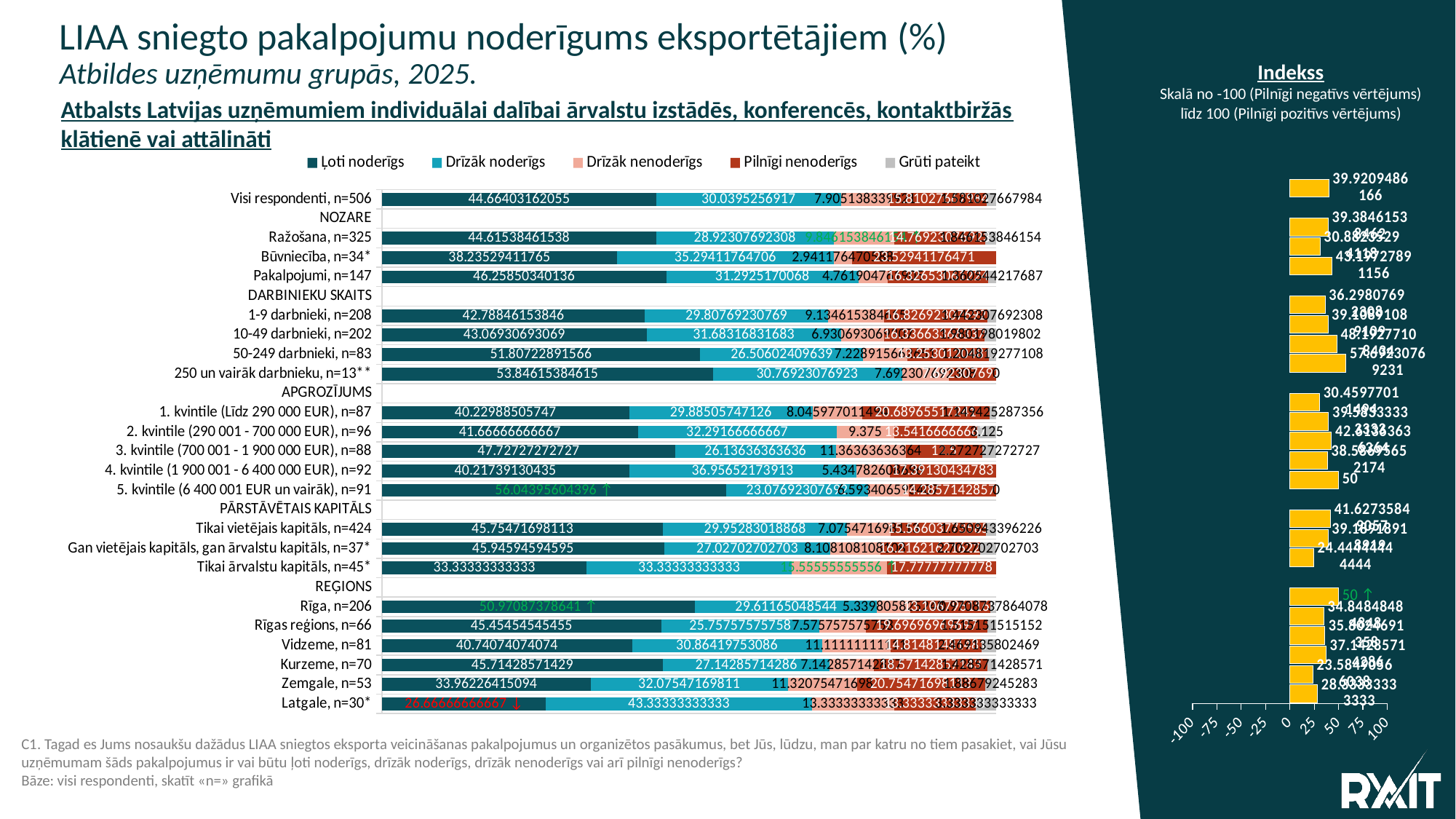
In the Indekss chart, is the value for 'Visi respondenti, n=506' greater or less than 25? greater What kind of chart is used to show the usefulness ratings by respondent group? Stacked bar chart In the Indekss chart, what is the index value for 'Visi respondenti, n=506'? 39.9209486166 In the main chart, what is the 'Drīzāk noderīgs' value for 'Latgale, n=30*'? 43.33333333333 In the main chart, what is the 'Ļoti noderīgs' value for '250 un vairāk darbinieku, n=13**'? 53.84615384615 In the main chart, which respondent group has the lowest 'Ļoti noderīgs' value? Latgale, n=30* How many series does the legend of the main chart list? 5 In the main chart, what is the difference between the 'Ļoti noderīgs' value for 'Rīga, n=206' and for 'Visi respondenti, n=506'? 6.30684216586 In the main chart, what is the 'Ļoti noderīgs' value for 'Visi respondenti, n=506'? 44.66403162055 How many regions are listed under the REĢIONS group in the main chart? 6 In the main chart, which respondent group has the highest 'Ļoti noderīgs' value? 5. kvintile (6 400 001 EUR un vairāk), n=91 In the main chart, for 'Latgale, n=30*', which is larger: the 'Ļoti noderīgs' value or the 'Drīzāk noderīgs' value? Drīzāk noderīgs